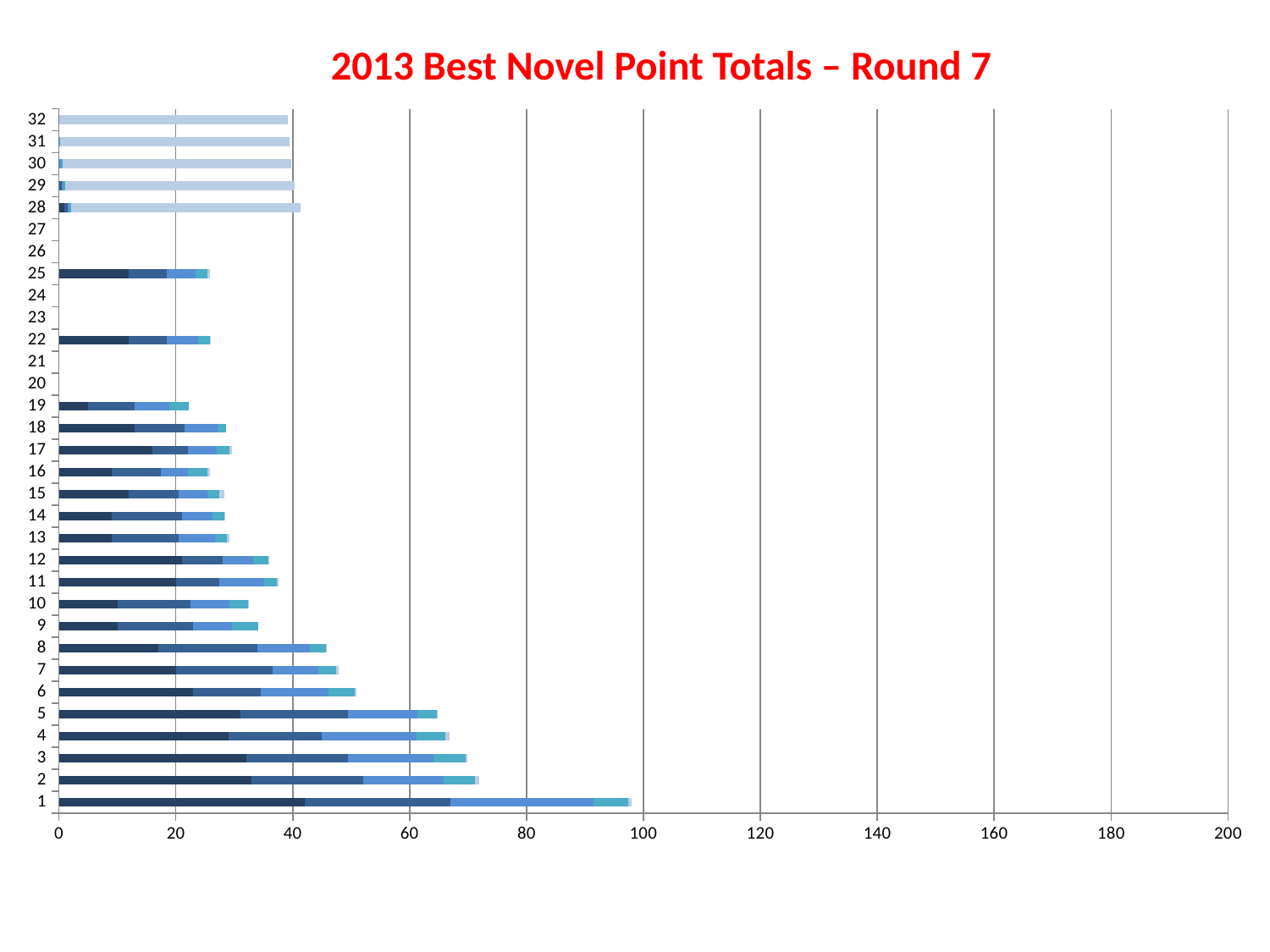
What is the title of the chart? 2013 Best Novel Point Totals – Round 7 Which has the larger total, category 6 or category 12? 6 Is the total for category 1 greater or less than 80? greater Is the total for category 6 greater or less than 40? greater How many categories are listed on the vertical axis of the chart? 32 Which category has the highest total in the chart? 1 Is the total for category 2 greater or less than 60? greater What is the highest value shown on the horizontal axis? 200 What kind of chart is shown on the slide? bar chart Which has the larger total, category 1 or category 2? 1